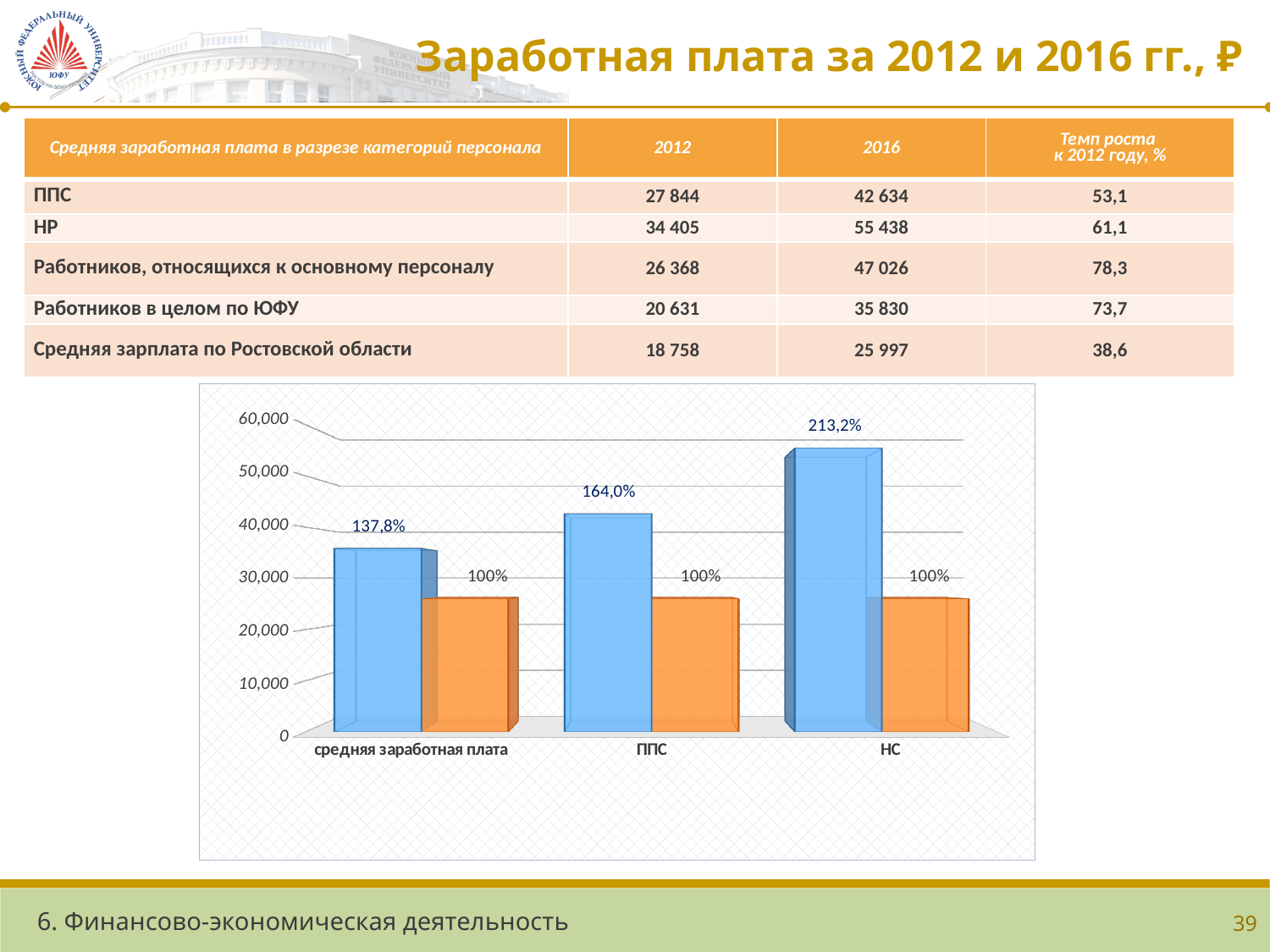
What data label is shown above the orange bar for ППС? 100% What kind of chart is shown on the slide? bar chart How many categories are shown on the x axis of the chart? 3 Which category has the tallest blue bar? НС Is the blue bar for средняя заработная плата greater or less than 40,000? less What data label is shown above the blue bar for средняя заработная плата? 137,8% Which category has the shortest blue bar? средняя заработная плата Is the orange bar for ППС greater or less than 30,000? less Do the blue bars rise or fall from left to right across the categories? rise Is the blue bar for НС greater or less than 50,000? greater What data label is shown above the blue bar for ППС? 164,0% What data label is shown above the blue bar for НС? 213,2%